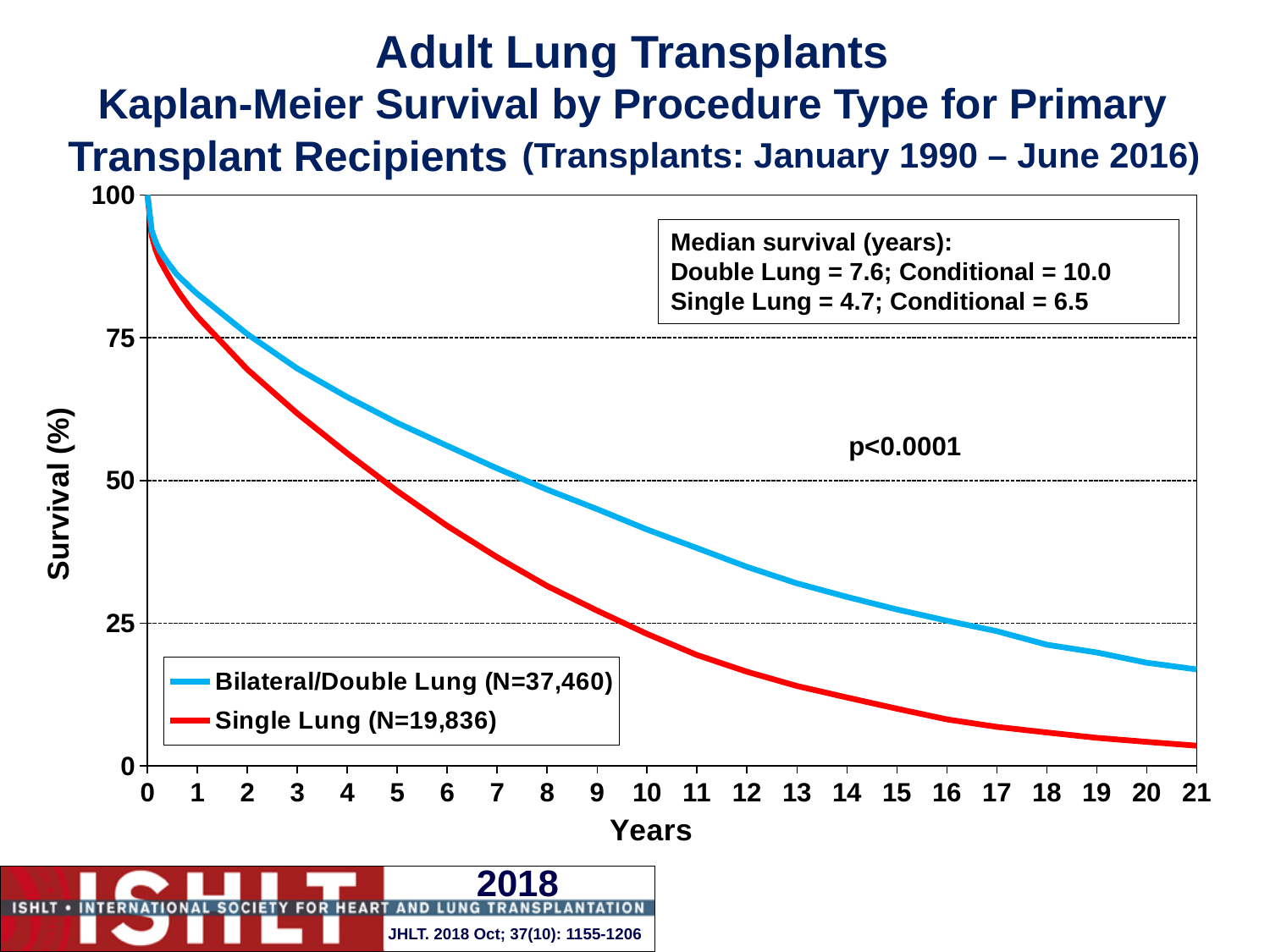
What is the conditional median survival in years for Single Lung recipients? 6.5 Is the survival for Bilateral/Double Lung at 5 years greater or less than 50%? greater What p-value is printed on the chart? p<0.0001 What is the median survival in years for Double Lung recipients according to the text box? 7.6 How many series does the legend list? 2 At 10 years, which group has higher survival, Bilateral/Double Lung or Single Lung? Bilateral/Double Lung What kind of chart is shown on the slide? Line chart Is the survival for Single Lung at 15 years greater or less than 25%? less What is the median survival in years for Single Lung recipients according to the text box? 4.7 What is the N for the Bilateral/Double Lung group shown in the legend? 37,460 Which series is shown in red in the legend? Single Lung (N=19,836) Do the survival curves rise or fall as years increase? Fall